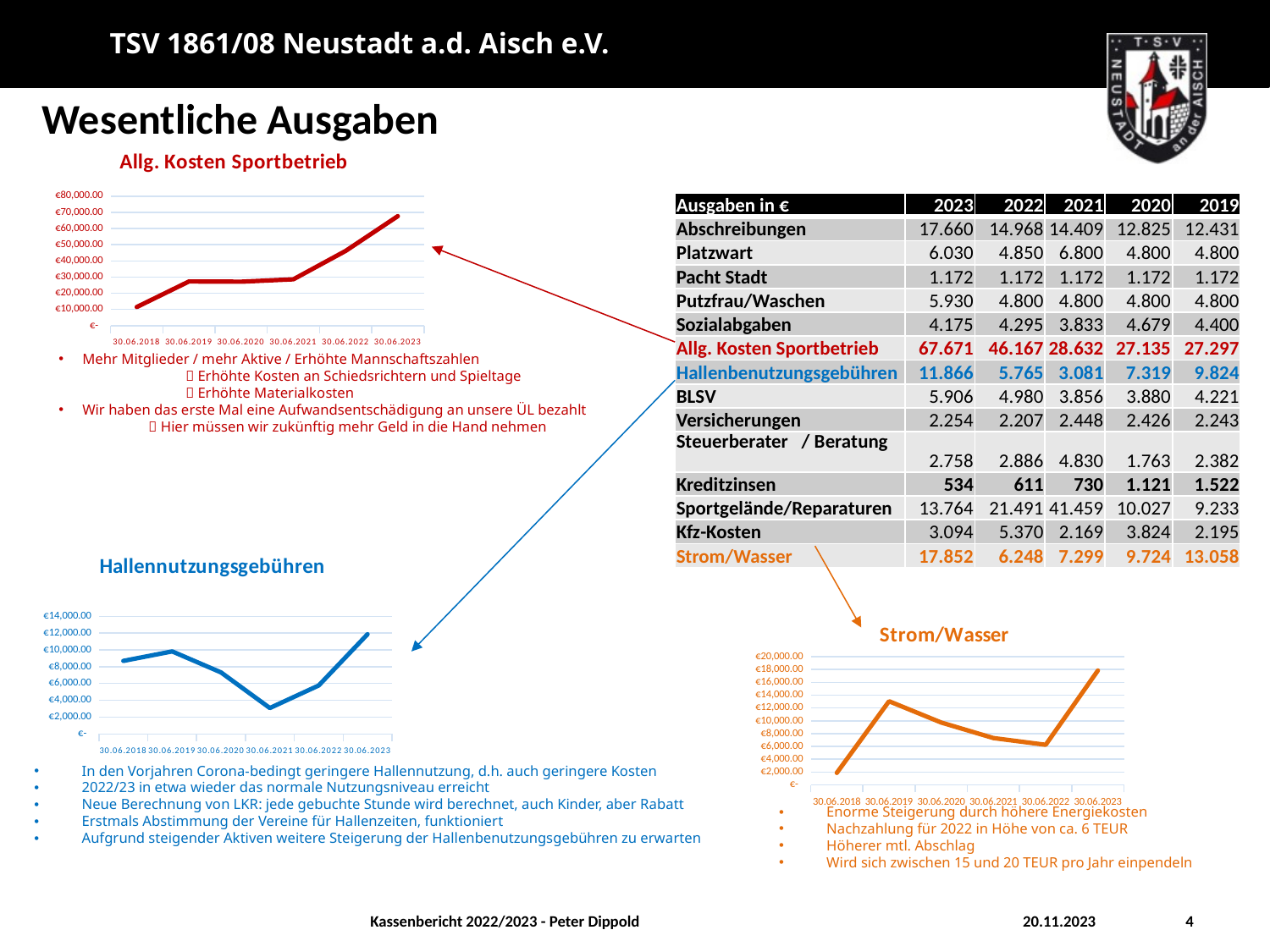
In the 'Strom/Wasser' chart, is the value for 30.06.2022 greater or less than €8,000.00? less In the 'Allg. Kosten Sportbetrieb' chart, which date has the lowest value? 30.06.2018 In the 'Allg. Kosten Sportbetrieb' chart, is the value for 30.06.2023 greater or less than €60,000.00? greater In the 'Hallennutzungsgebühren' chart, which date has the highest value? 30.06.2023 What kind of chart is the 'Allg. Kosten Sportbetrieb' chart? line chart In the 'Hallennutzungsgebühren' chart, is the value for 30.06.2021 greater or less than €4,000.00? less In the 'Strom/Wasser' chart, do the values rise or fall from 30.06.2019 to 30.06.2022? fall In the 'Allg. Kosten Sportbetrieb' chart, which date has the highest value? 30.06.2023 In the 'Strom/Wasser' chart, which date has the highest value? 30.06.2023 How many data points are plotted in the 'Hallennutzungsgebühren' chart? 6 In the 'Hallennutzungsgebühren' chart, which date has the lowest value? 30.06.2021